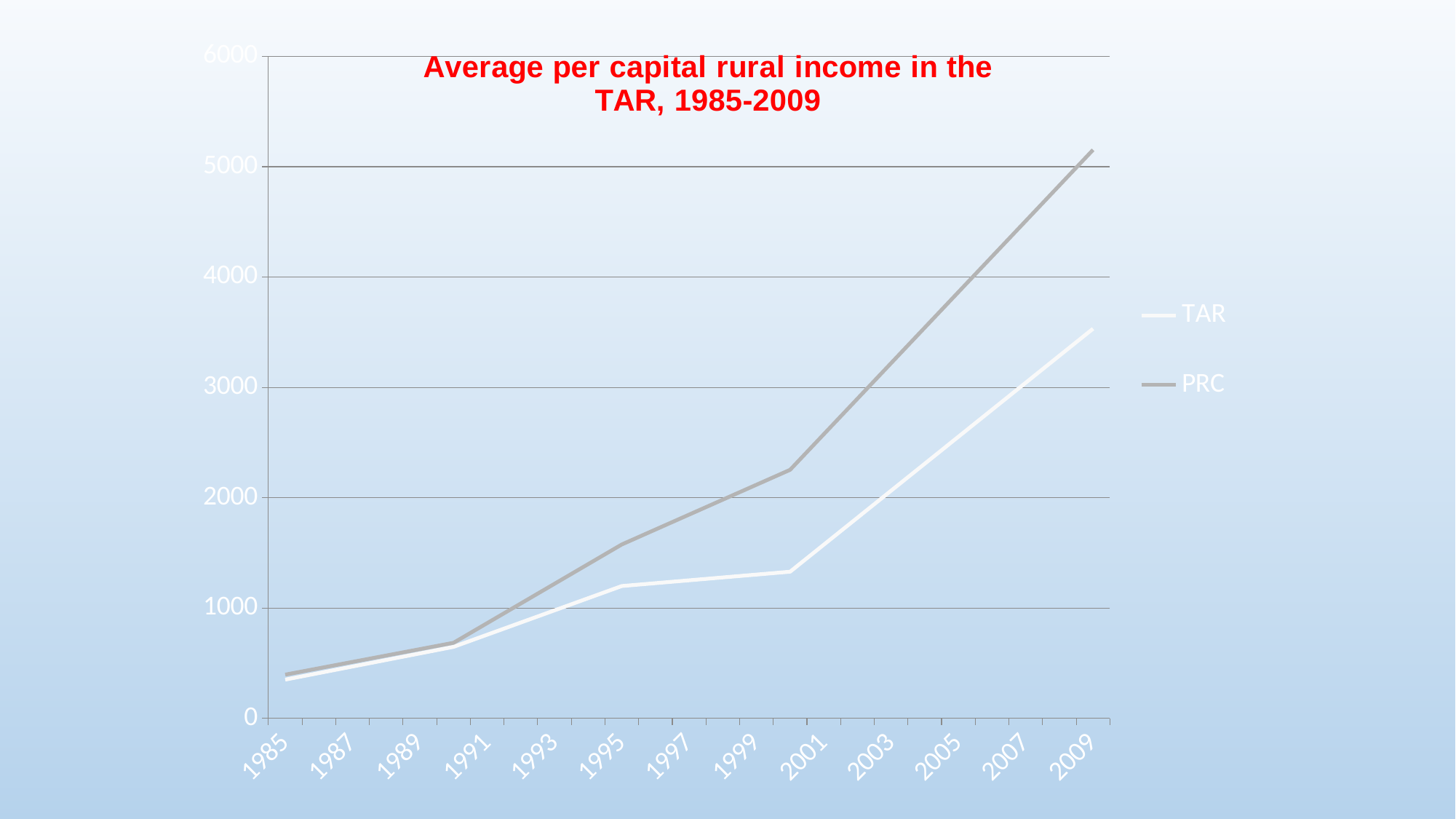
What is the title of the chart? Average per capital rural income in the TAR, 1985-2009 What are the two series named in the legend? TAR and PRC Do the values for the PRC series rise or fall from 1985 to 2009? rise Is the value for TAR in 1985 greater or less than 1000? less How many series does the legend list? 2 Which series has the higher value in 2009, TAR or PRC? PRC Do the values for the TAR series rise or fall from 1985 to 2009? rise What kind of chart is shown on the slide? line chart How many year labels are shown on the x axis? 13 Is the value for TAR in 2009 greater or less than 3000? greater Is the value for PRC in 2009 greater or less than 4000? greater